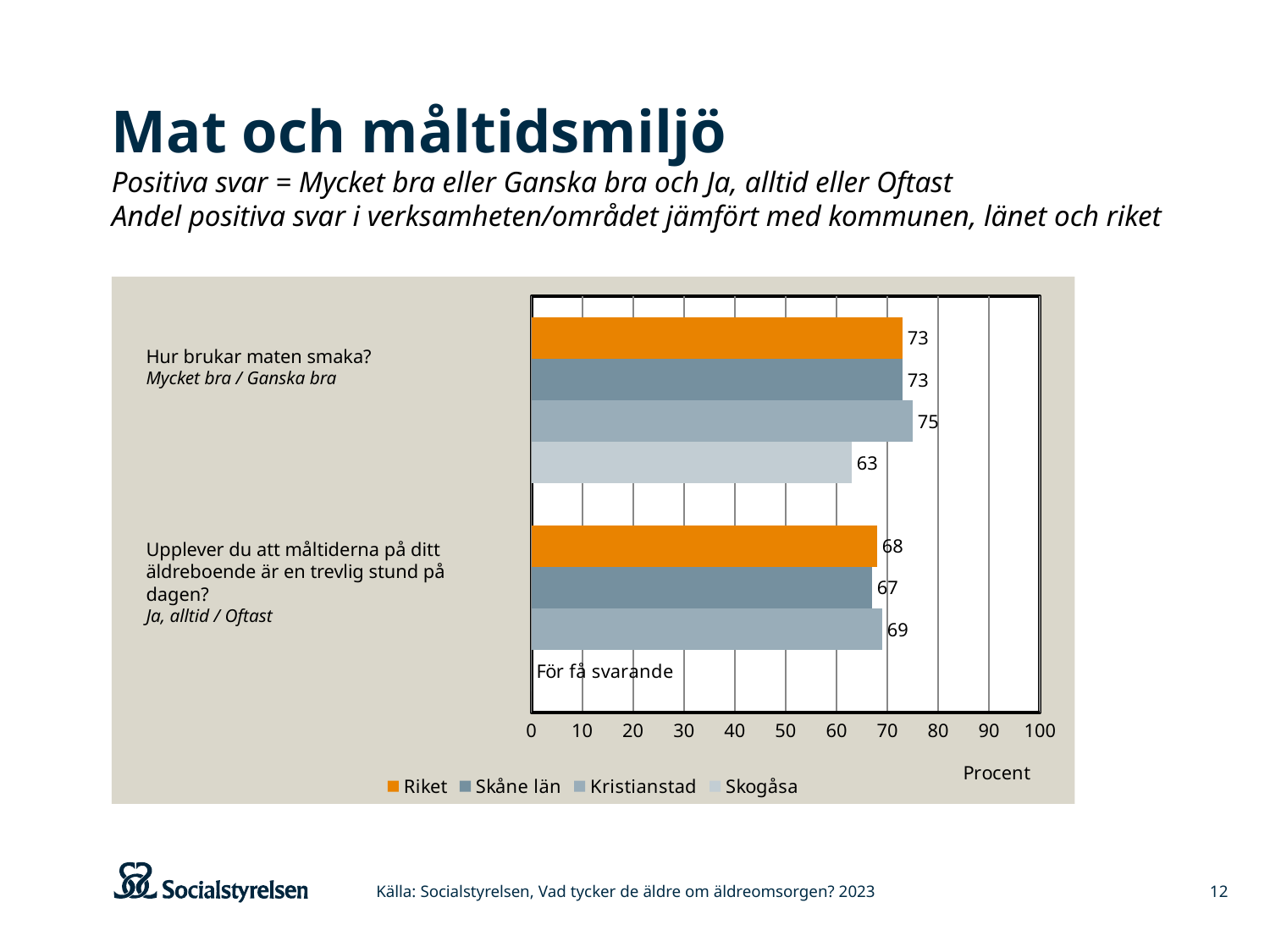
Which series has the highest value on the question "Hur brukar maten smaka?"? Kristianstad What is shown instead of a bar for Skogåsa on the question "Upplever du att måltiderna på ditt äldreboende är en trevlig stund på dagen?"? För få svarande Which series has the lowest value on the question "Hur brukar maten smaka?"? Skogåsa What is the value for Skogåsa on the question "Hur brukar maten smaka?"? 63 What kind of chart is shown on the slide? Bar chart Which is larger on the question "Upplever du att måltiderna på ditt äldreboende är en trevlig stund på dagen?": Riket or Skåne län? Riket What is the value for Kristianstad on the question "Hur brukar maten smaka?"? 75 What is the difference between Kristianstad and Skogåsa on the question "Hur brukar maten smaka?"? 12 What is the value for Riket on the question "Upplever du att måltiderna på ditt äldreboende är en trevlig stund på dagen?"? 68 How many series does the legend list? 4 What is the value for Skåne län on the question "Upplever du att måltiderna på ditt äldreboende är en trevlig stund på dagen?"? 67 What is the label of the x axis? Procent